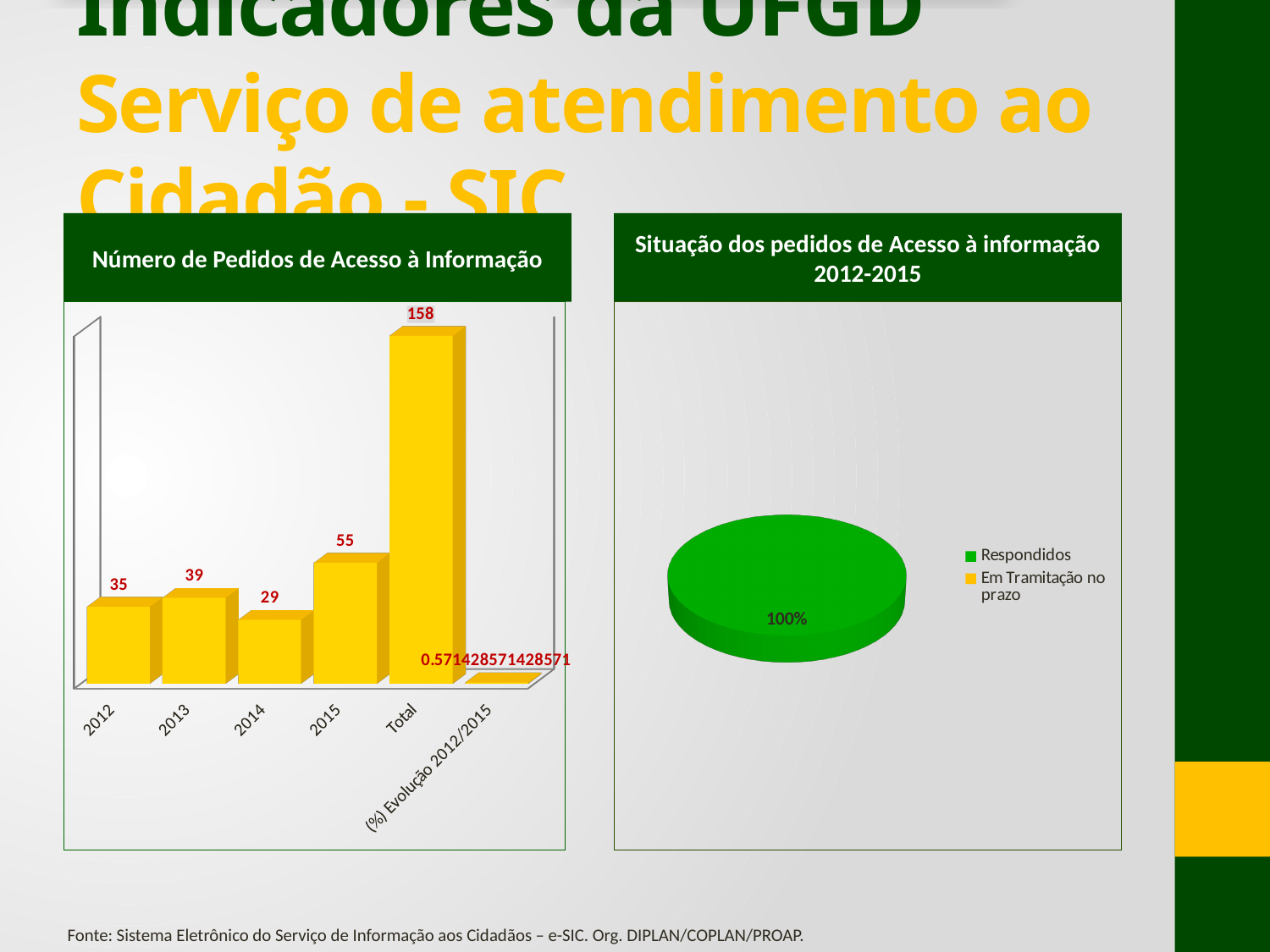
What kind of chart is 'Número de Pedidos de Acesso à Informação'? Bar chart In the chart 'Número de Pedidos de Acesso à Informação', how many categories are shown on the x axis? 6 How many entries does the legend of the pie chart 'Situação dos pedidos de Acesso à informação 2012-2015' list? 2 In the chart 'Número de Pedidos de Acesso à Informação', which year from 2012 to 2015 has the lowest number of requests? 2014 In the chart 'Número de Pedidos de Acesso à Informação', which year from 2012 to 2015 has the highest number of requests? 2015 In the chart 'Número de Pedidos de Acesso à Informação', what is the value labelled for '(%) Evolução 2012/2015'? 0.571428571428571 In the pie chart 'Situação dos pedidos de Acesso à informação 2012-2015', what share is shown for Respondidos? 100% In the chart 'Número de Pedidos de Acesso à Informação', which is larger, the value for 2013 or the value for 2012? 2013 In the chart 'Número de Pedidos de Acesso à Informação', what is the value for 2012? 35 In the chart 'Número de Pedidos de Acesso à Informação', what is the difference between the values for 2015 and 2014? 26 In the chart 'Número de Pedidos de Acesso à Informação', what is the value for Total? 158 In the chart 'Número de Pedidos de Acesso à Informação', what is the value for 2015? 55